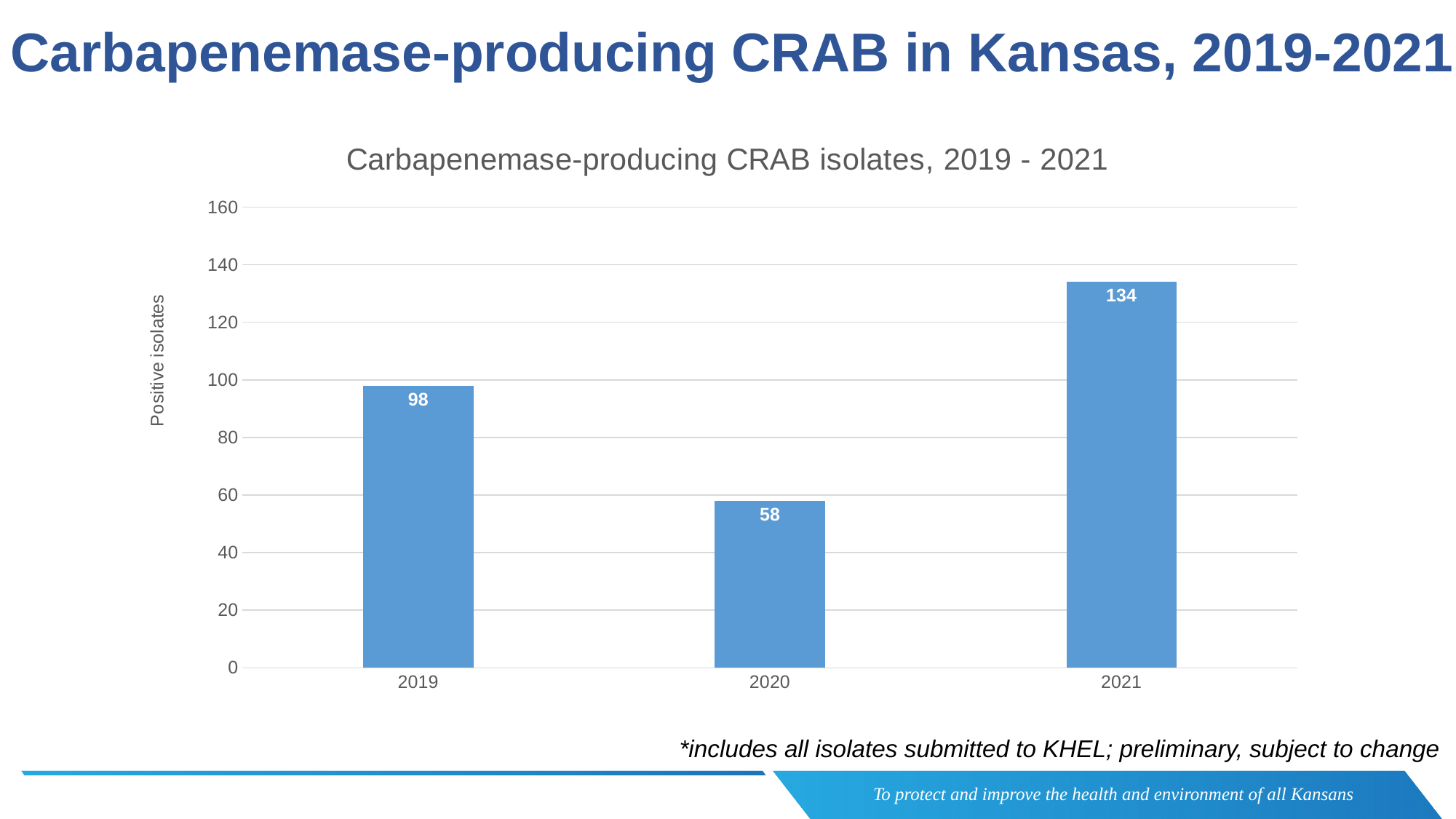
What kind of chart is shown on the slide? Bar chart What is the number of positive isolates for 2019? 98 Which year has the lowest number of positive isolates? 2020 What is the title of the chart? Carbapenemase-producing CRAB isolates, 2019 - 2021 What is the difference in positive isolates between 2021 and 2020? 76 What is the difference in positive isolates between 2019 and 2020? 40 What is the number of positive isolates for 2021? 134 What is the number of positive isolates for 2020? 58 Which year has more positive isolates, 2019 or 2021? 2021 How many years are shown on the x axis? 3 Is the value for 2021 greater or less than 120? greater Which year has the highest number of positive isolates? 2021